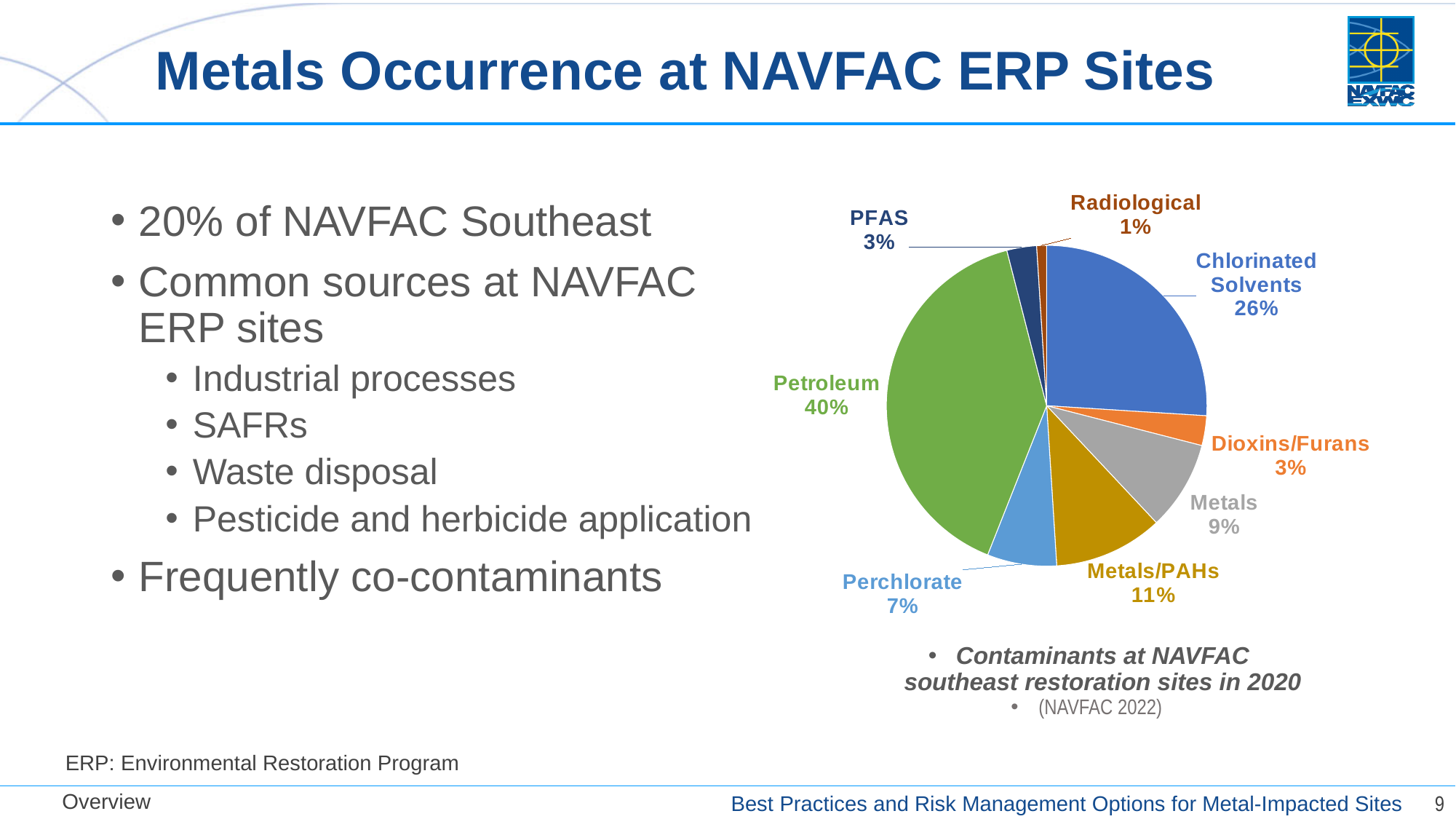
Which is larger, Metals or Metals/PAHs? Metals/PAHs What is the caption below the pie chart? Contaminants at NAVFAC southeast restoration sites in 2020 What is the difference in percentage points between Petroleum and Chlorinated Solvents? 14 What percentage of the pie does Petroleum account for? 40% Which category has the smallest slice of the pie? Radiological What type of chart is shown on the slide? pie chart How many categories are shown in the pie chart? 8 What is the value shown for Chlorinated Solvents? 26% What is the combined percentage of Metals and Metals/PAHs? 20% What percentage is shown for Perchlorate? 7% Which category has the largest slice of the pie? Petroleum What share is shown for Metals/PAHs? 11%